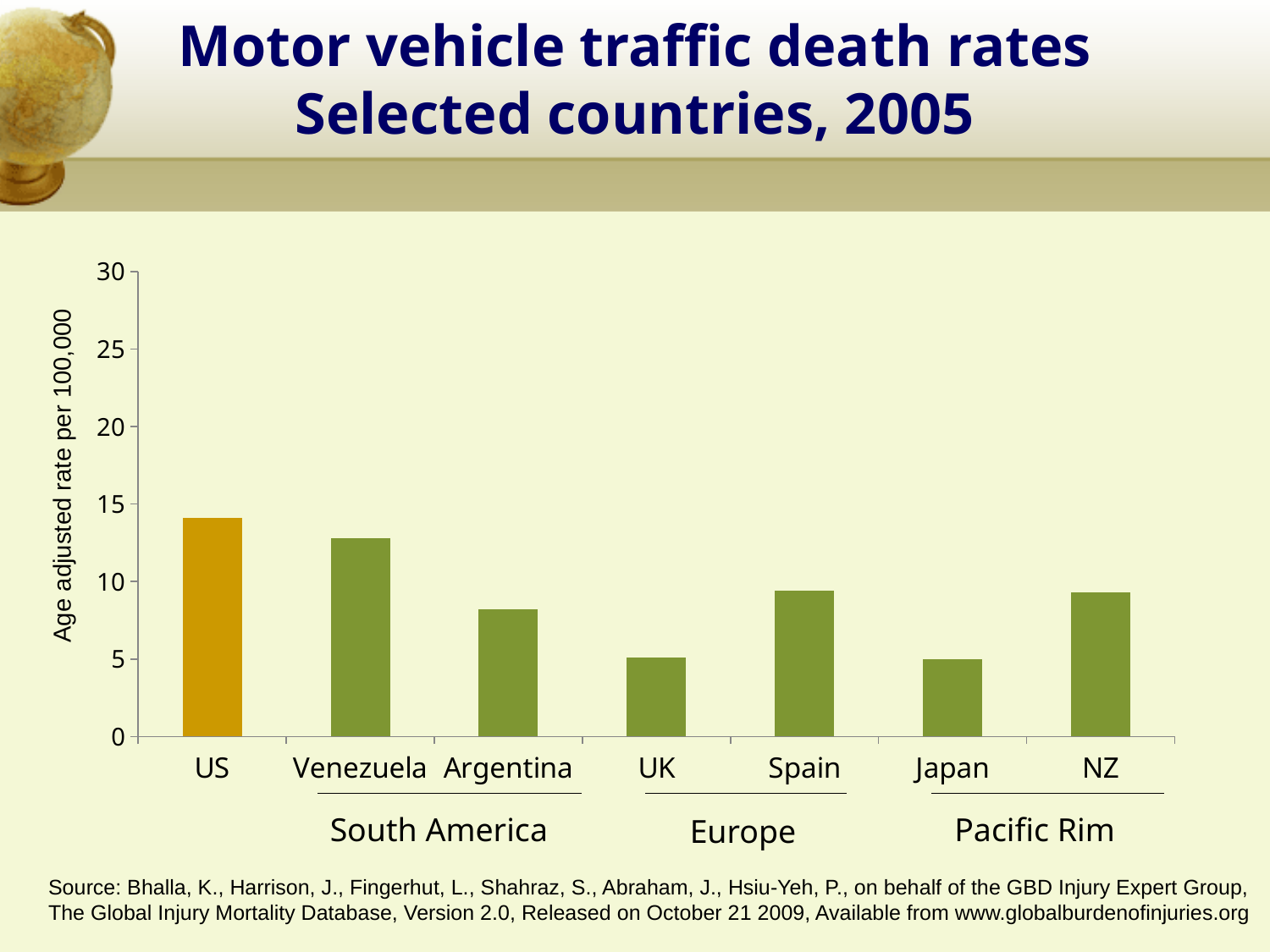
What is the label on the vertical axis of the chart? Age adjusted rate per 100,000 Which country has the highest motor vehicle traffic death rate in the chart? US Which has a higher death rate, Spain or the UK? Spain Is the value for the UK greater or less than 10? less What kind of chart is shown on the slide? bar chart Is the value for the US greater or less than 10? greater Is the value for Argentina greater or less than 5? greater Which regional group do Japan and NZ belong to in the chart? Pacific Rim Which has a higher death rate, Venezuela or Argentina? Venezuela How many countries are shown in the chart? 7